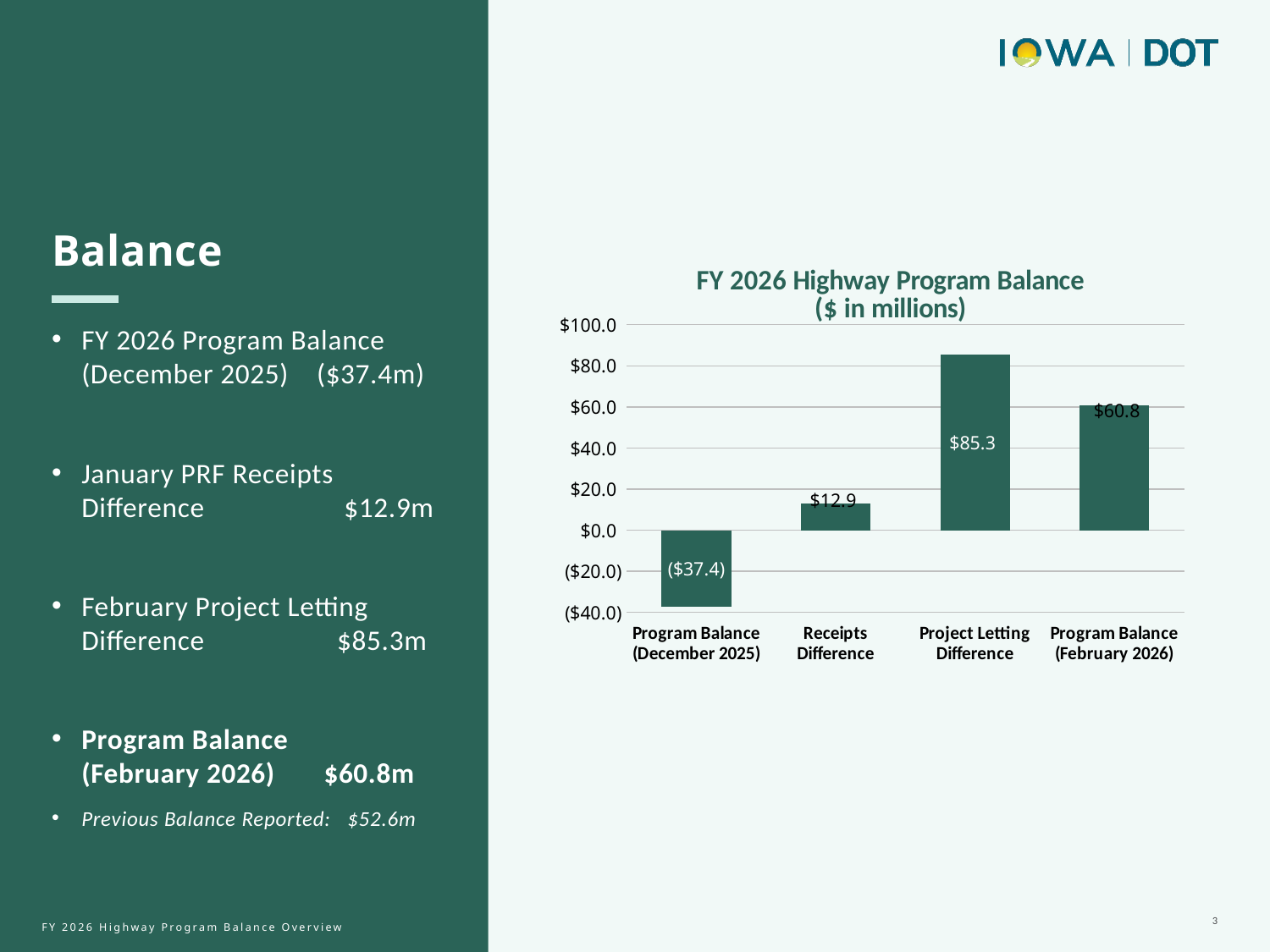
Which is larger, Receipts Difference or Program Balance (February 2026)? Program Balance (February 2026) What kind of chart is shown on the slide? Bar chart What is the value for Program Balance (December 2025)? ($37.4) Is the value for Project Letting Difference greater or less than $80.0? greater What is the value for Project Letting Difference? $85.3 What is the value for Receipts Difference? $12.9 What is the difference between Project Letting Difference and Program Balance (February 2026)? $24.5 What is the title of the chart? FY 2026 Highway Program Balance ($ in millions) Which category has the highest value? Project Letting Difference How many categories are shown on the chart? 4 Which category has the lowest value? Program Balance (December 2025) What is the value for Program Balance (February 2026)? $60.8